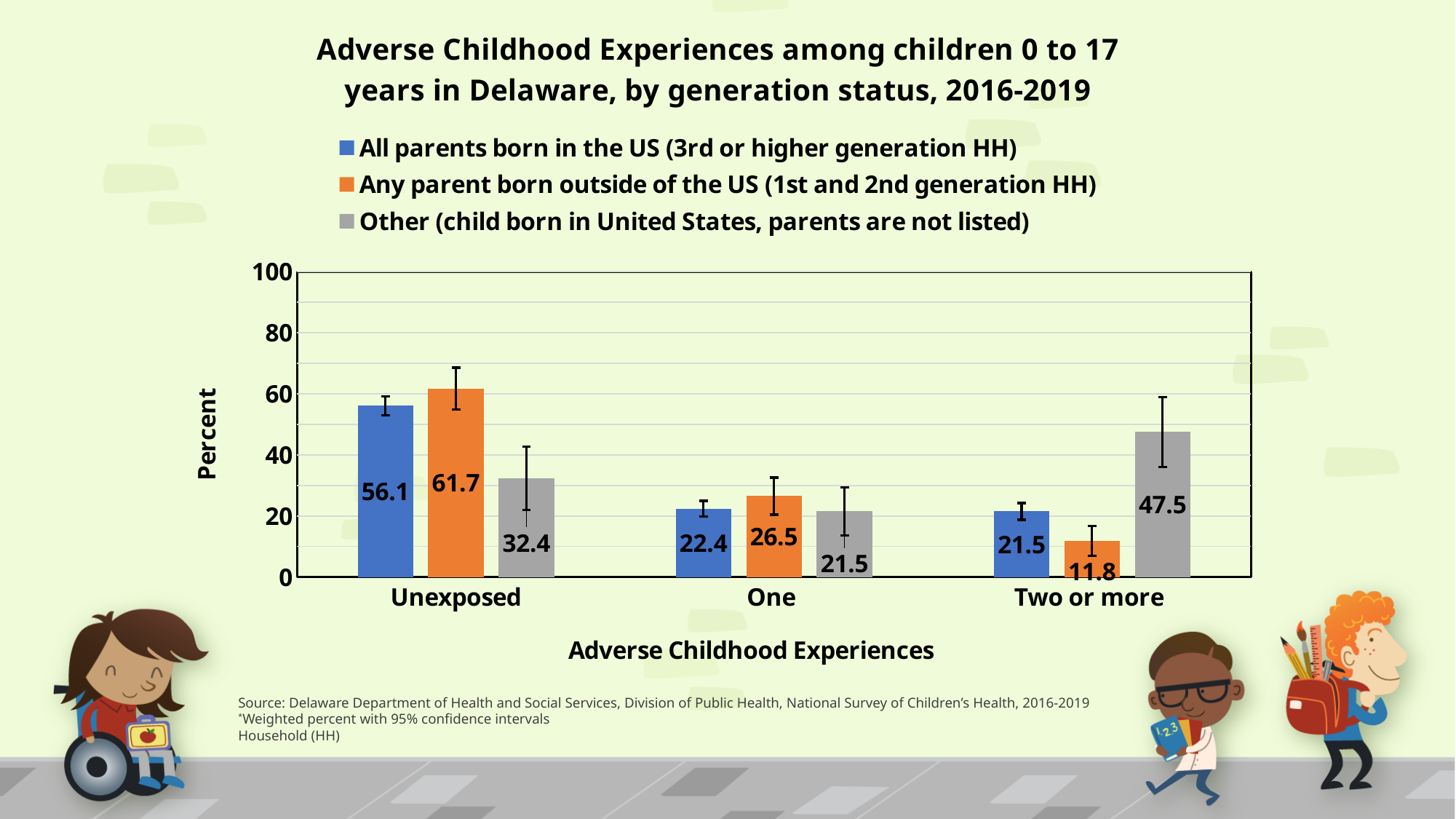
Is the value for 'Other' in the Unexposed category greater or less than 40? less What is the value for 'Any parent born outside of the US (1st and 2nd generation HH)' in the Two or more category? 11.8 What is the value for 'Other (child born in United States, parents are not listed)' in the One category? 21.5 What is the difference between the 'Any parent born outside of the US' value and the 'All parents born in the US' value in the Unexposed category? 5.6 How many series does the legend list? 3 What kind of chart is shown on the slide? Bar chart Which series has the lowest value in the Two or more category? Any parent born outside of the US (1st and 2nd generation HH) What is the label of the y axis? Percent How many categories are shown on the x axis? 3 Which series has the highest value in the Unexposed category? Any parent born outside of the US (1st and 2nd generation HH) In the Two or more category, which is larger: the value for 'Other' or the value for 'All parents born in the US'? Other (child born in United States, parents are not listed) What is the value for 'All parents born in the US (3rd or higher generation HH)' in the Unexposed category? 56.1